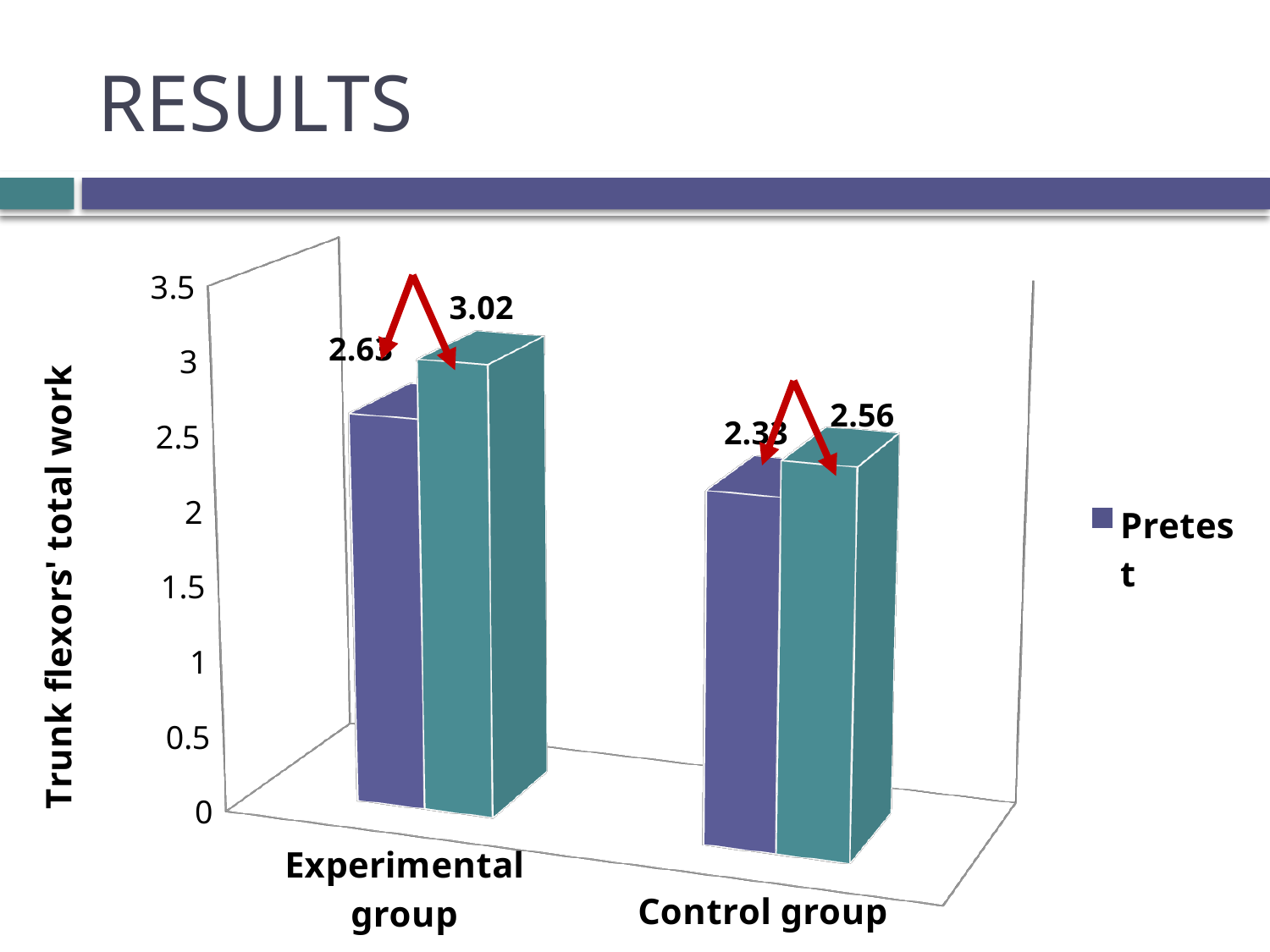
What value is labelled on the teal (second) bar for the Control group? 2.56 Which group contains the highest bar in the chart? Experimental group Is the Pretest value for the Experimental group greater or less than 2.5? greater What is the difference between the teal bar values for the Experimental group (3.02) and the Control group (2.56)? 0.46 How many groups (categories) are shown on the x axis of the chart? 2 What kind of chart is shown on the slide? bar chart What is the title of the vertical axis of the chart? Trunk flexors' total work Which group has the larger teal (second) bar value, Experimental group or Control group? Experimental group In the Experimental group, is the Pretest bar taller or shorter than the teal (second) bar? shorter Is the Pretest value for the Control group greater or less than 2.5? less What value is labelled on the teal (second) bar for the Experimental group? 3.02 Which series name is readable in the chart legend? Pretest